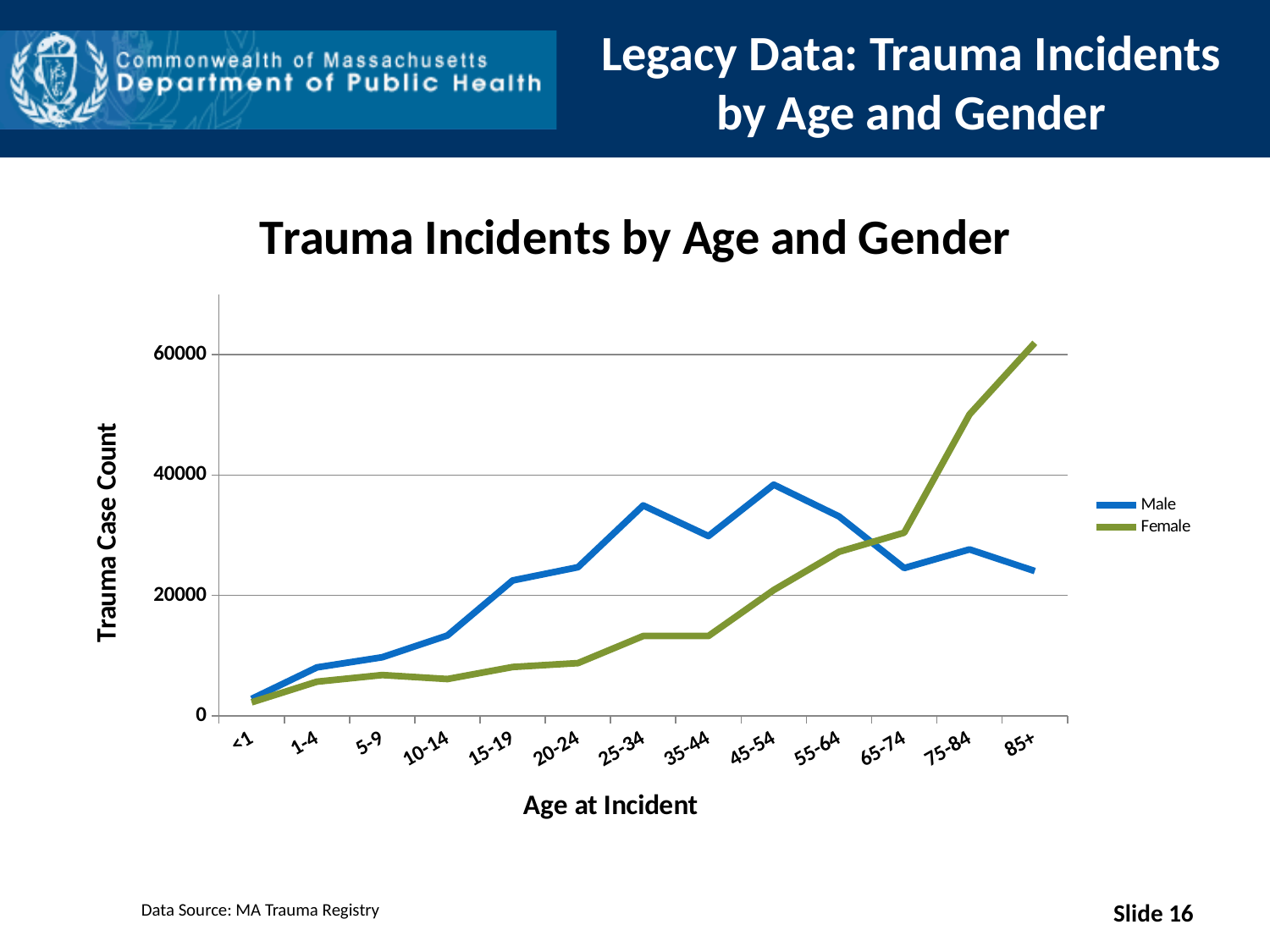
At age 85+, which series has the larger trauma case count, Male or Female? Female For which age group is the Male trauma case count highest? 45-54 For which age group is the Female trauma case count highest? 85+ What kind of chart is shown on the slide? line chart For which age group is the Female trauma case count lowest? <1 What is the label of the y axis? Trauma Case Count Is the Female value for 35-44 greater or less than 20000? less At age 25-34, which series has the larger trauma case count, Male or Female? Male How many age categories are shown on the x axis? 13 Is the Male value for 45-54 greater or less than 40000? less Is the Female value for 85+ greater or less than 60000? greater How many series does the legend list? 2